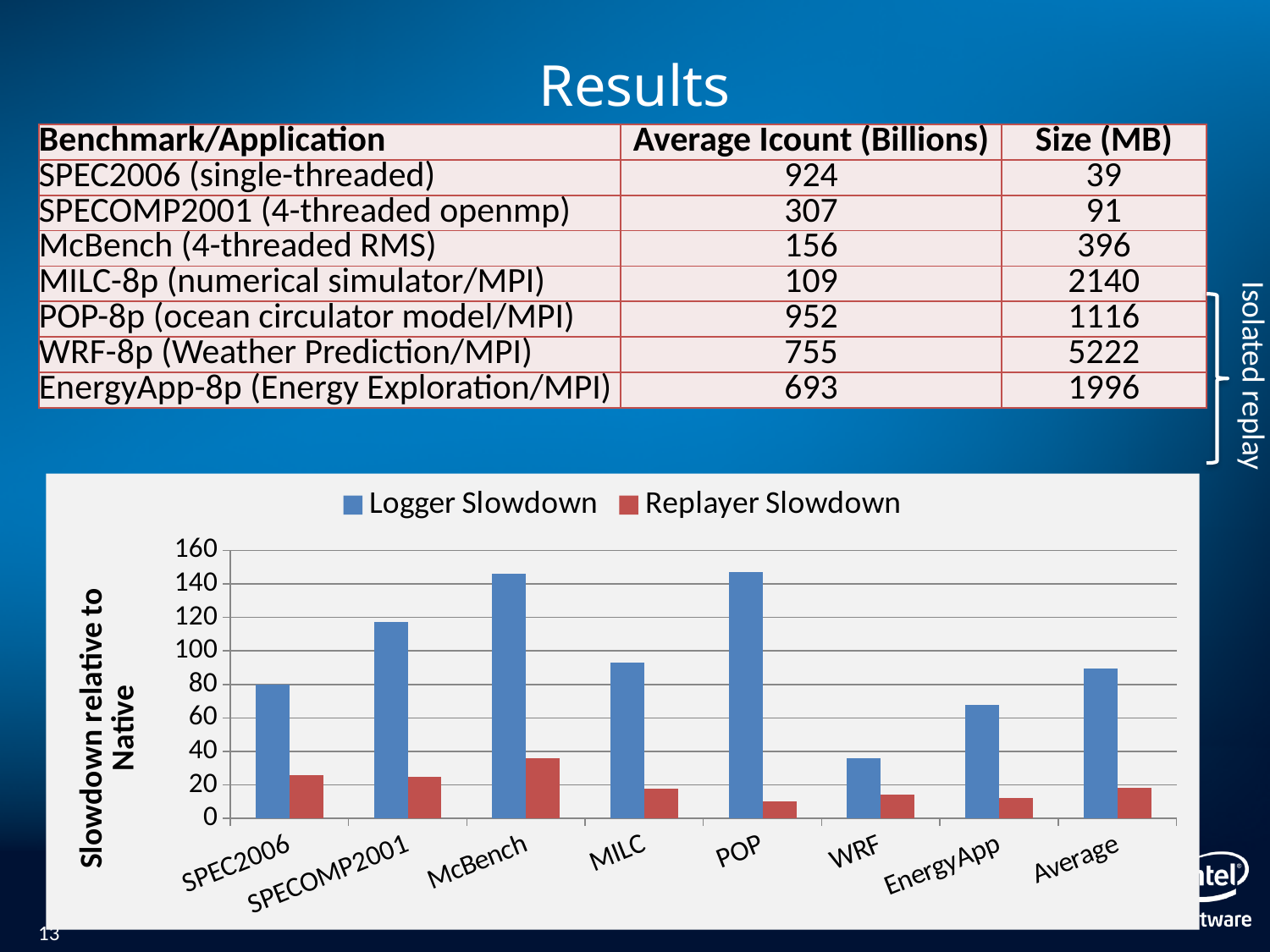
Is the Logger Slowdown for SPECOMP2001 greater or less than 100? greater Which category has the highest Replayer Slowdown? McBench What kind of chart is shown on the slide? bar chart How many categories are shown along the x axis of the chart? 8 What is the title of the chart's vertical axis? Slowdown relative to Native Which category has the lowest Logger Slowdown? WRF Is the Replayer Slowdown for POP greater or less than 20? less Which has a larger Logger Slowdown, WRF or EnergyApp? EnergyApp How many series does the chart's legend list? 2 Is the Logger Slowdown for McBench greater or less than 140? greater Which has a larger Logger Slowdown, SPECOMP2001 or MILC? SPECOMP2001